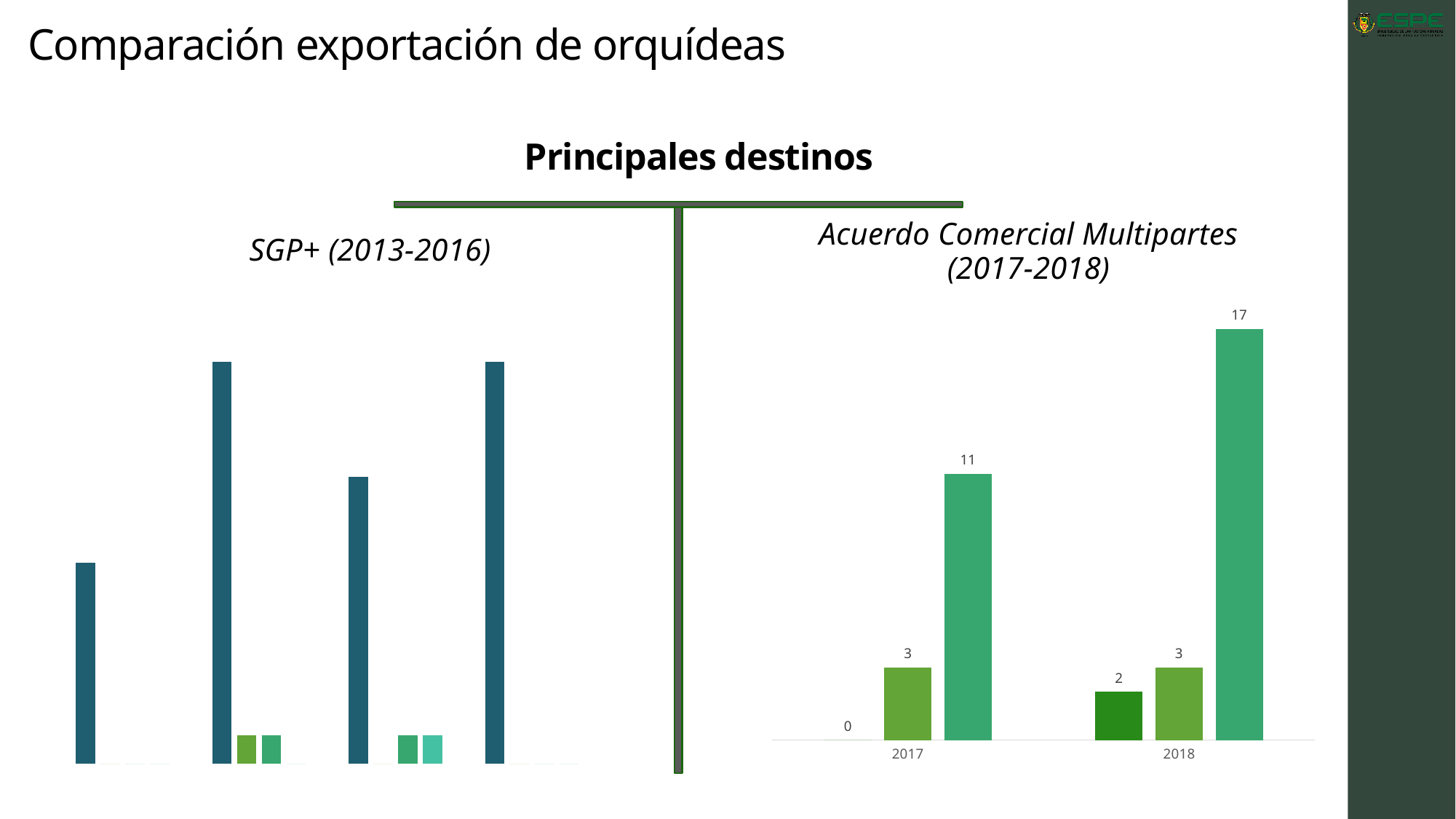
What is the title of the chart on the left side of the slide? SGP+ (2013-2016) In the chart titled 'Acuerdo Comercial Multipartes (2017-2018)', which year has the taller maximum bar, 2017 or 2018? 2018 What kind of chart is the one on the right side of the slide, titled 'Acuerdo Comercial Multipartes (2017-2018)'? bar chart In the chart titled 'Acuerdo Comercial Multipartes (2017-2018)', what is the highest value shown? 17 In the chart titled 'Acuerdo Comercial Multipartes (2017-2018)', what is the value of the tallest bar for 2017? 11 How many groups of bars are shown in the chart on the left side of the slide, titled 'SGP+ (2013-2016)'? 4 In the chart titled 'Acuerdo Comercial Multipartes (2017-2018)', what is the value of the dark green bar for 2018? 2 In the chart titled 'Acuerdo Comercial Multipartes (2017-2018)', what is the difference between the tallest bar for 2018 and the tallest bar for 2017? 6 In the chart titled 'Acuerdo Comercial Multipartes (2017-2018)', what is the lowest value shown? 0 In the chart titled 'Acuerdo Comercial Multipartes (2017-2018)', does the value of the tallest bar rise or fall from 2017 to 2018? rise In the chart titled 'Acuerdo Comercial Multipartes (2017-2018)', how many years are shown on the x axis? 2 In the chart titled 'Acuerdo Comercial Multipartes (2017-2018)', what is the value of the tallest bar for 2018? 17